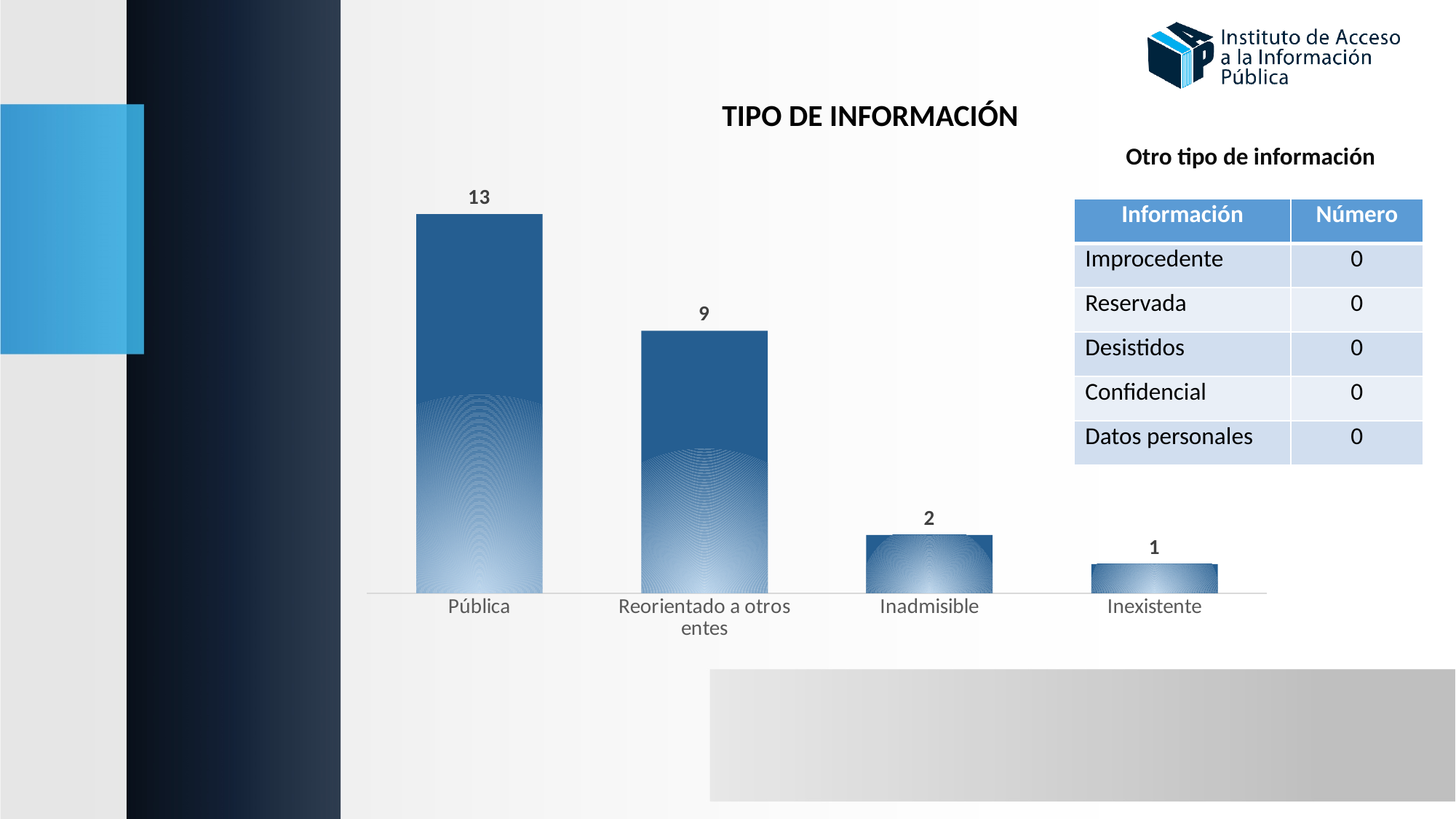
What is the value for Inadmisible? 2 What is the value for Reorientado a otros entes? 9 What is the value for Pública? 13 How many categories are shown in the chart? 4 Which is larger, the value for Inadmisible or the value for Inexistente? Inadmisible Which category has the highest value? Pública Which category has the lowest value? Inexistente What kind of chart is shown on the slide? Bar chart Do the values rise or fall from left to right along the x axis? Fall What is the title of the chart? TIPO DE INFORMACIÓN What is the difference between the values for Pública and Reorientado a otros entes? 4 What is the value for Inexistente? 1